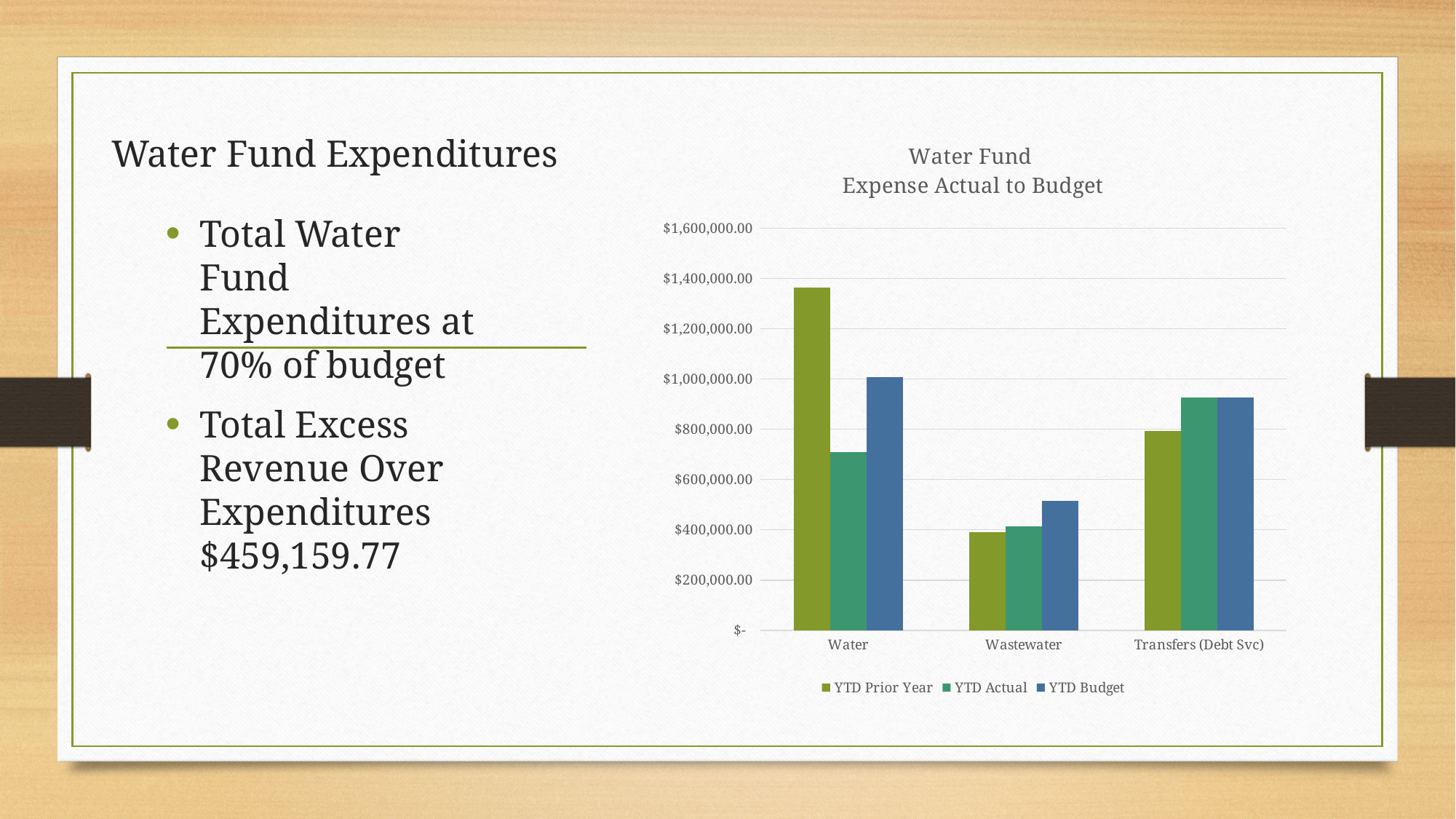
Is the YTD Prior Year value for Water greater or less than $1,200,000.00? greater Is the YTD Actual value for Water greater or less than $800,000.00? less Which category has the lowest YTD Budget value? Wastewater What kind of chart is shown on the slide? bar chart How many categories are shown on the x axis of the chart? 3 Which category has the highest YTD Prior Year value? Water What is the title of the chart? Water Fund Expense Actual to Budget For Transfers (Debt Svc), which is larger: YTD Prior Year or YTD Actual? YTD Actual Is the YTD Budget value for Wastewater greater or less than $600,000.00? less How many series does the legend of the chart list? 3 For Water, which is larger: YTD Prior Year or YTD Budget? YTD Prior Year Which series is shown in blue in the chart? YTD Budget